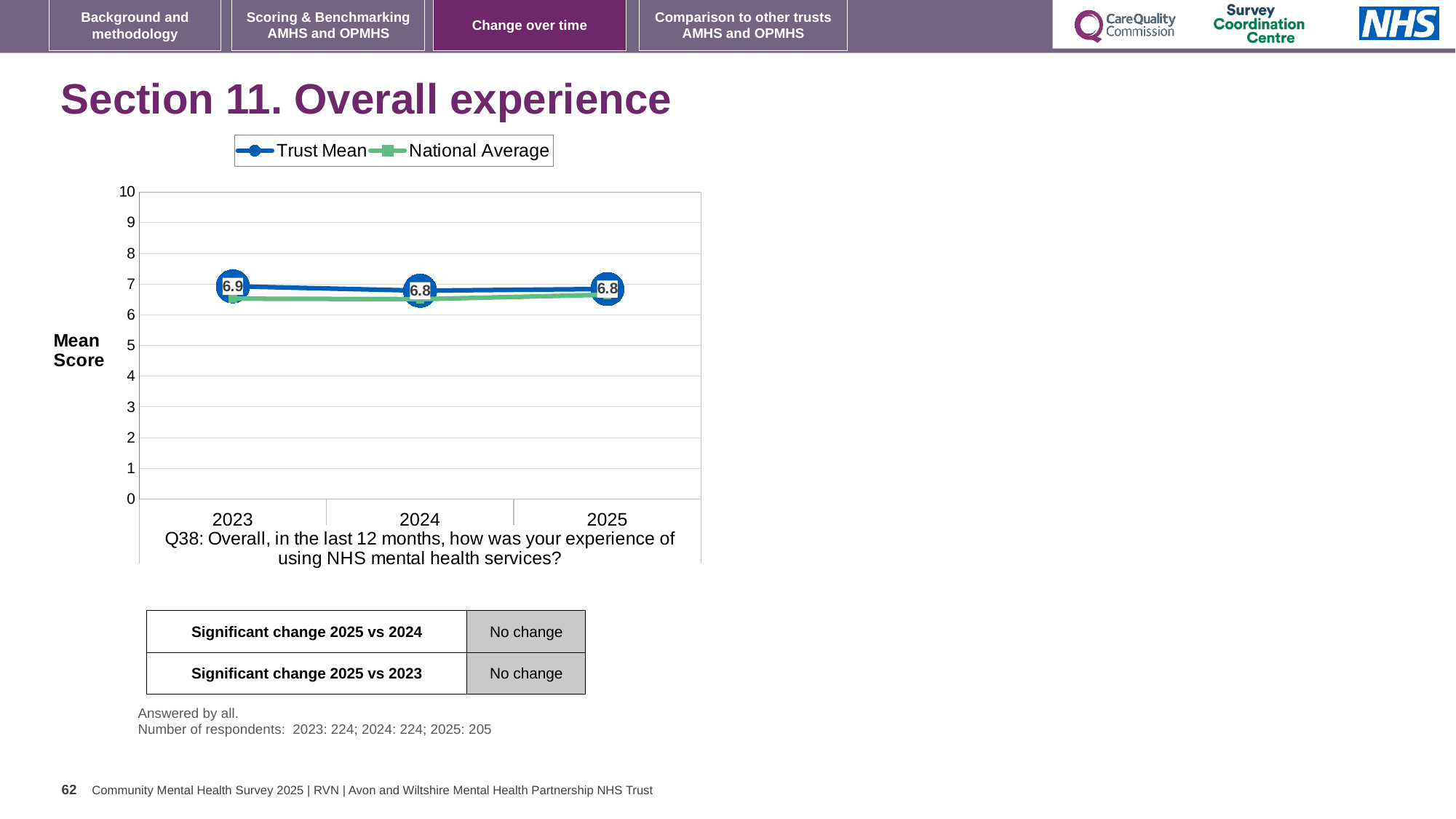
Is the National Average value for 2023 greater or less than 7? less What kind of chart is shown on the slide? Line chart How many years are shown on the x axis of the chart? 3 What is the Trust Mean value for 2023? 6.9 What is the Trust Mean value for 2024? 6.8 Is the National Average value for 2024 greater or less than 6? greater What is the label on the y axis of the chart? Mean Score What is the difference between the Trust Mean in 2023 and in 2024? 0.1 How many series does the chart legend list? 2 In 2023, which is larger: the Trust Mean or the National Average? Trust Mean In which year is the Trust Mean highest? 2023 What is the Trust Mean value for 2025? 6.8